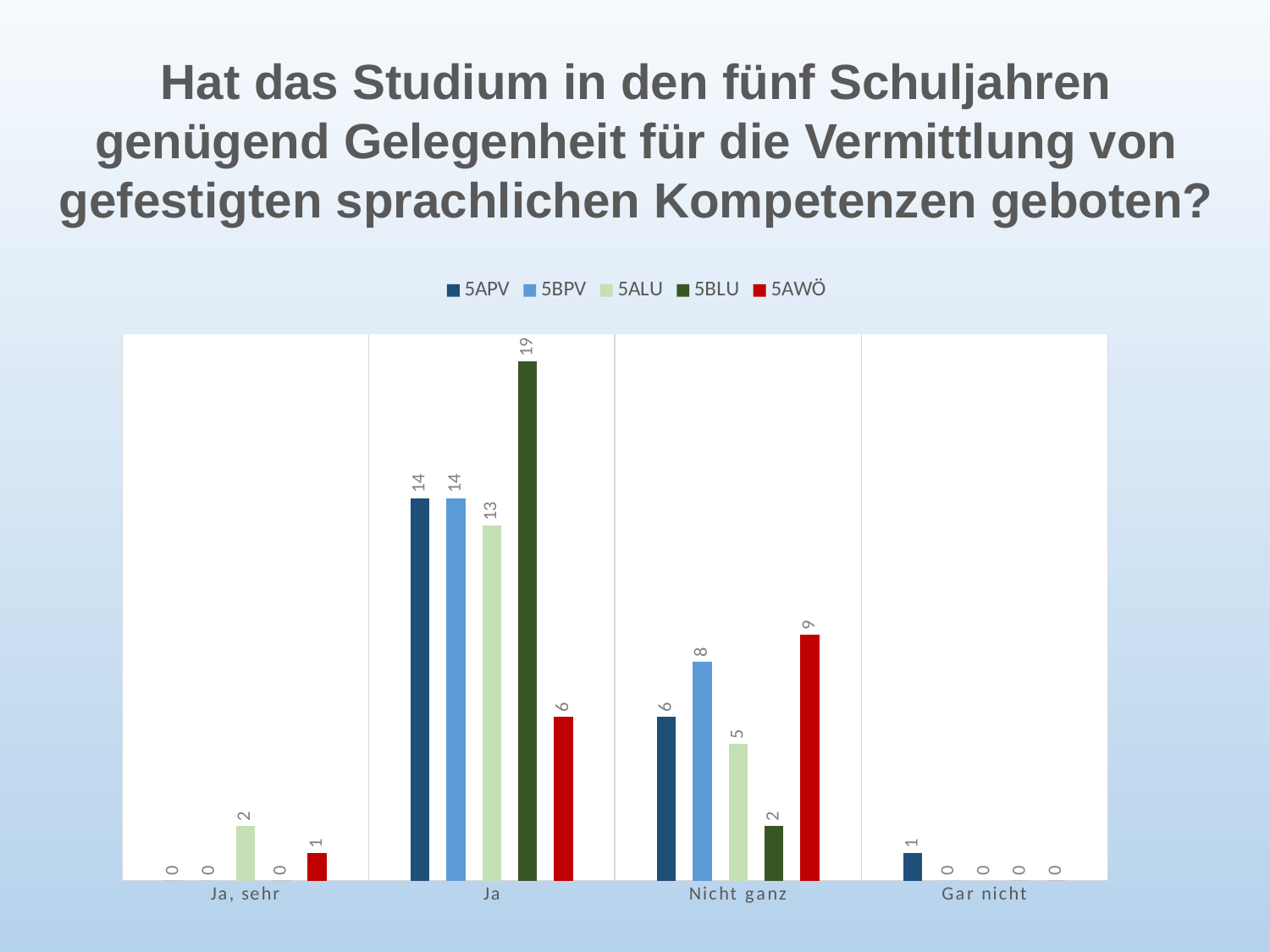
What is the value for 5BLU in the "Ja" category? 19 Which series is shown in red in the legend? 5AWÖ How many categories are shown on the x axis? 4 In the "Nicht ganz" category, which is larger: the value for 5BPV or the value for 5ALU? 5BPV Which series has the highest value in the "Ja" category? 5BLU What is the difference between the 5BLU and 5AWÖ values in the "Ja" category? 13 What kind of chart is shown on the slide? Bar chart Which series has the lowest value in the "Nicht ganz" category? 5BLU How many series does the legend list? 5 What is the value for 5ALU in the "Ja, sehr" category? 2 What is the value for 5APV in the "Gar nicht" category? 1 What is the value for 5AWÖ in the "Nicht ganz" category? 9